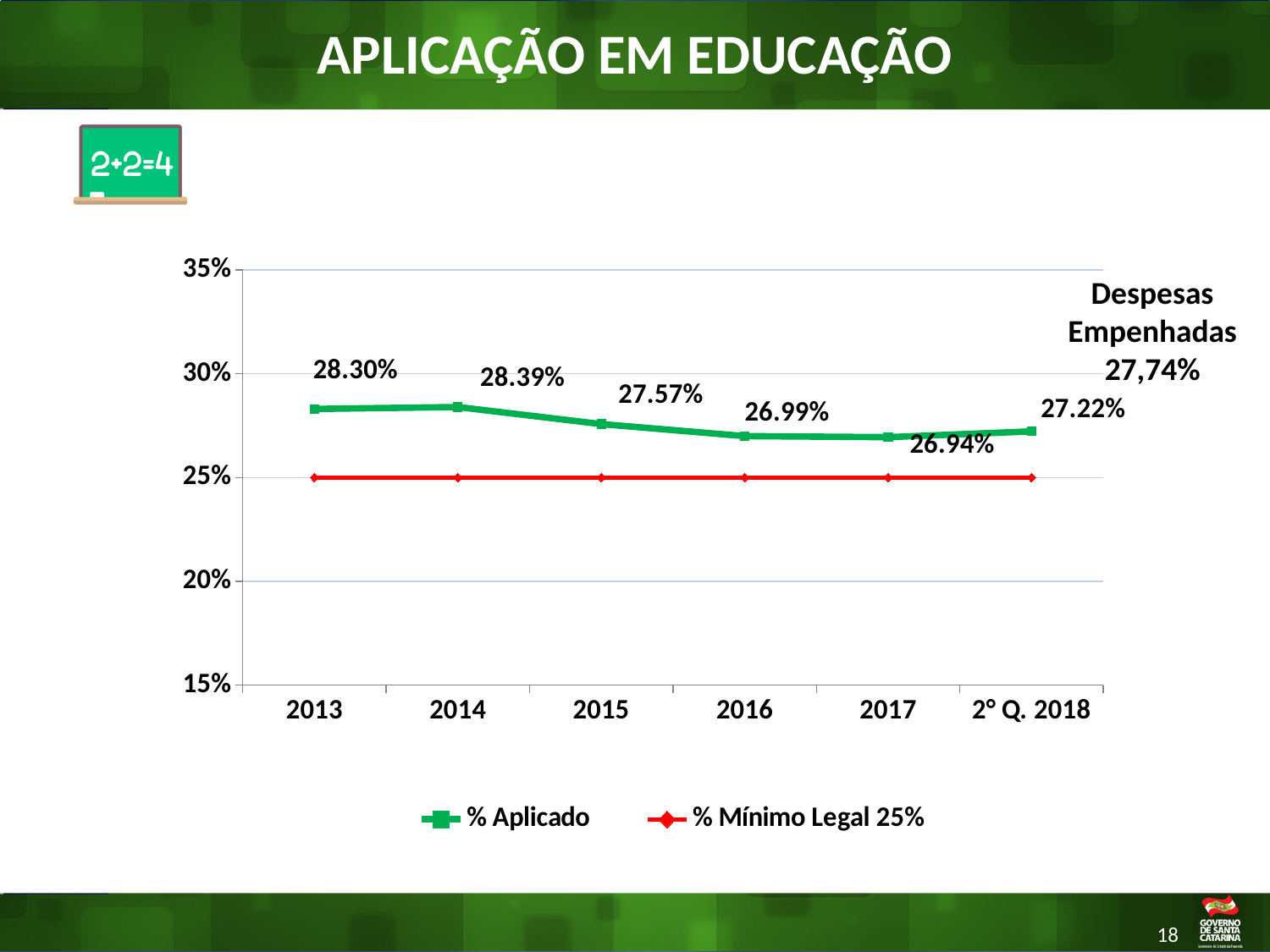
Does the % Aplicado series rise or fall from 2014 to 2017? fall Is the % Aplicado value for 2016 greater or less than 25%? greater What is the % Aplicado value for 2° Q. 2018? 27.22% How many series does the legend list? 2 What is the difference between the % Aplicado values for 2013 and 2016? 1.31% What is the % Aplicado value for 2014? 28.39% Which year has the lowest % Aplicado value? 2017 How many categories are shown on the x axis? 6 What kind of chart is shown on the slide? line chart Which year has the highest % Aplicado value? 2014 What is the % Aplicado value for 2017? 26.94% Which is larger, the % Aplicado value for 2015 or for 2° Q. 2018? 2015